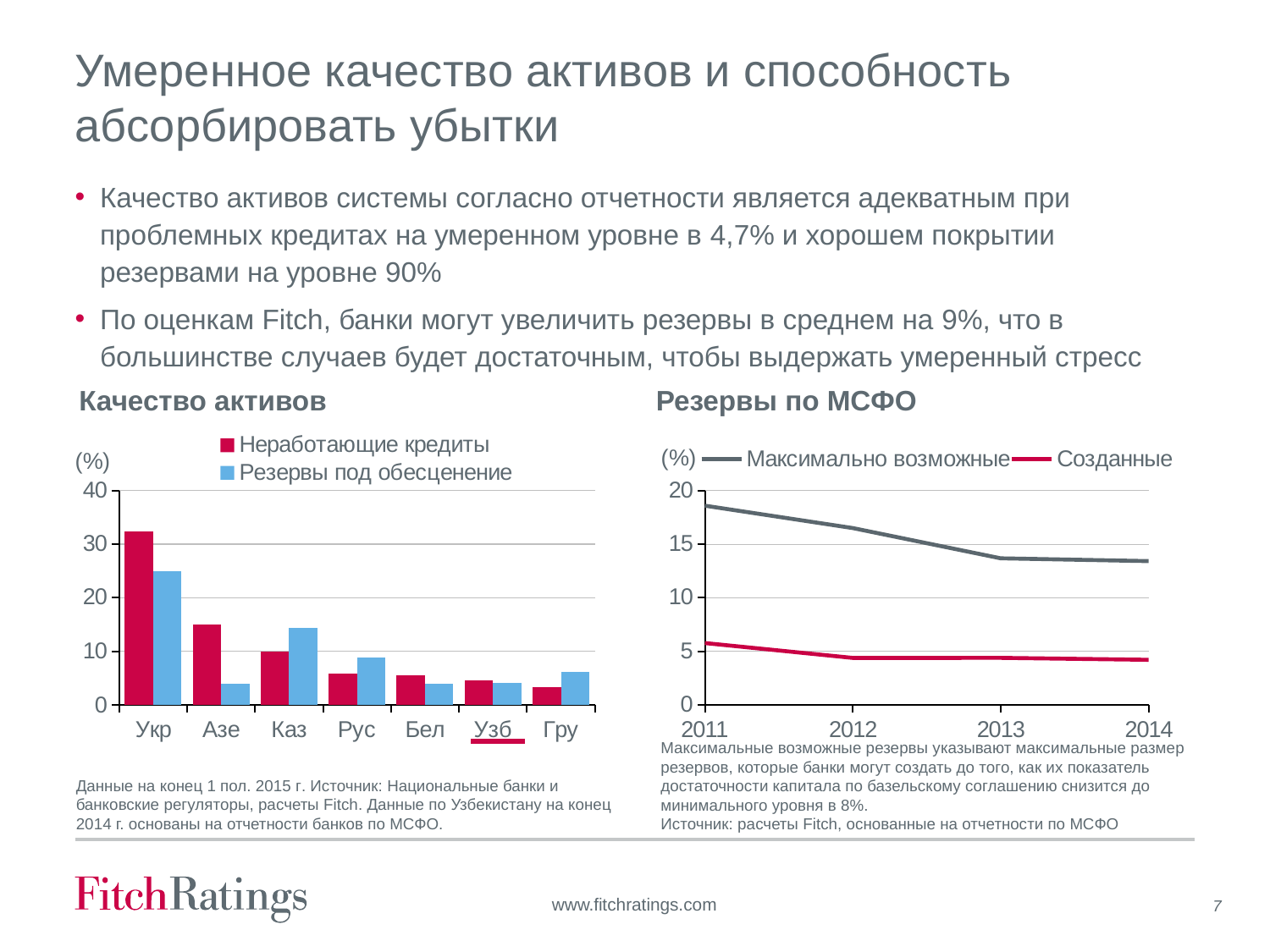
In the 'Качество активов' chart, for Каз, which is larger: Неработающие кредиты or Резервы под обесценение? Резервы под обесценение In the 'Качество активов' chart, for Азе, which is larger: Неработающие кредиты or Резервы под обесценение? Неработающие кредиты In the 'Качество активов' chart, is the Неработающие кредиты value for Укр greater or less than 30? greater In the 'Качество активов' chart, how many series does the legend list? 2 In the 'Качество активов' chart, which country has the highest value for Неработающие кредиты? Укр In the 'Резервы по МСФО' chart, is the Максимально возможные value for 2011 greater or less than 15? greater In the 'Качество активов' chart, how many countries are shown on the x axis? 7 In the 'Резервы по МСФО' chart, how many series does the legend list? 2 In the 'Резервы по МСФО' chart, how many years are shown on the x axis? 4 What kind of chart is the 'Качество активов' chart? bar chart What kind of chart is the 'Резервы по МСФО' chart? line chart In the 'Резервы по МСФО' chart, does the Максимально возможные line rise or fall from 2011 to 2014? fall